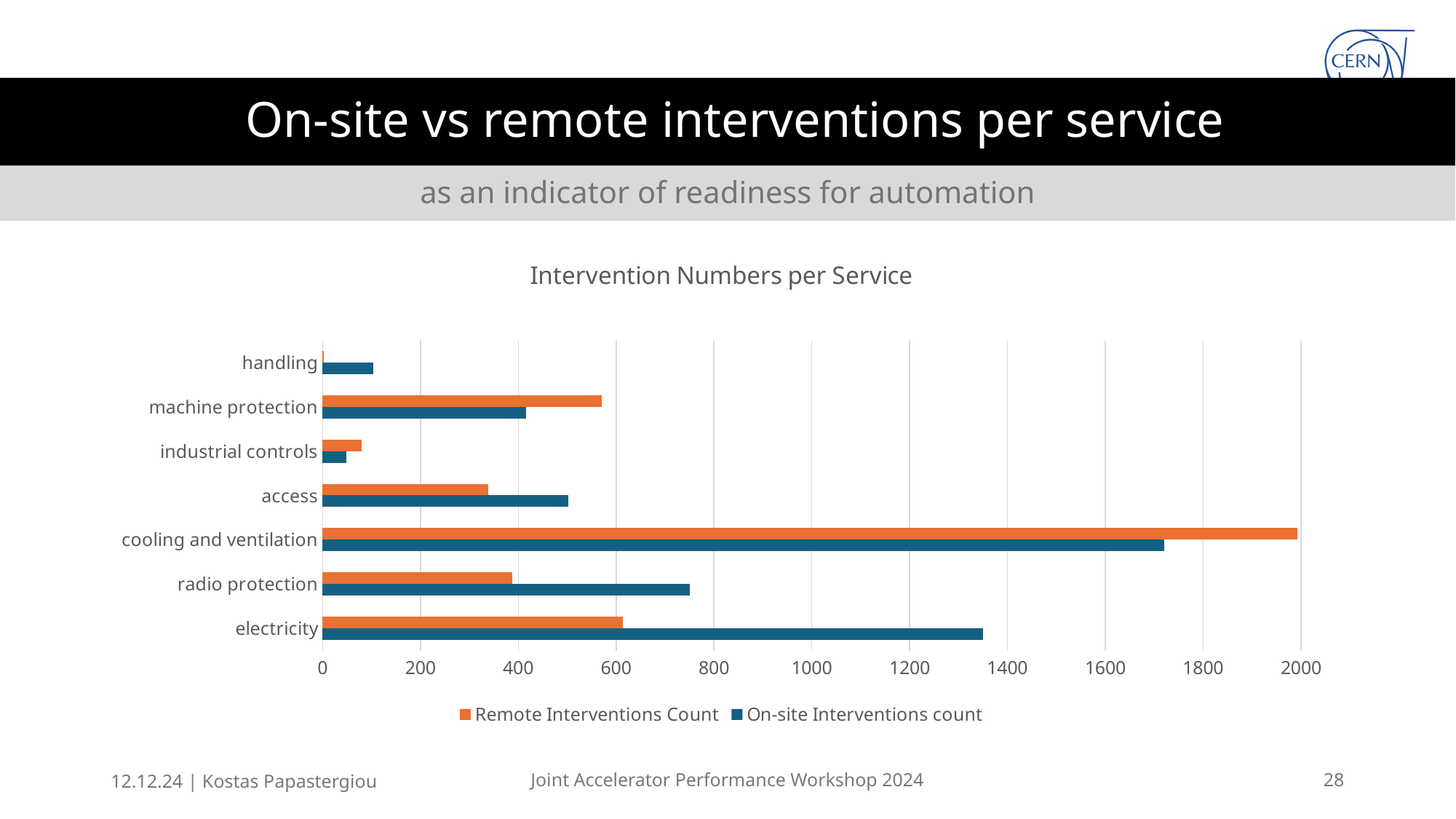
Which service has the lowest On-site Interventions count? industrial controls Which service has the lowest Remote Interventions Count? handling Is the On-site Interventions count for electricity greater or less than 1200? greater What is the title of the chart? Intervention Numbers per Service Which service has the highest Remote Interventions Count? cooling and ventilation Is the Remote Interventions Count for access greater or less than 400? less How many series does the legend list? 2 For electricity, which is larger: the Remote Interventions Count or the On-site Interventions count? On-site Interventions count How many services (categories) are shown in the chart? 7 Is the Remote Interventions Count for cooling and ventilation greater or less than 1800? greater Which service has the highest On-site Interventions count? cooling and ventilation What kind of chart is shown on the slide? bar chart